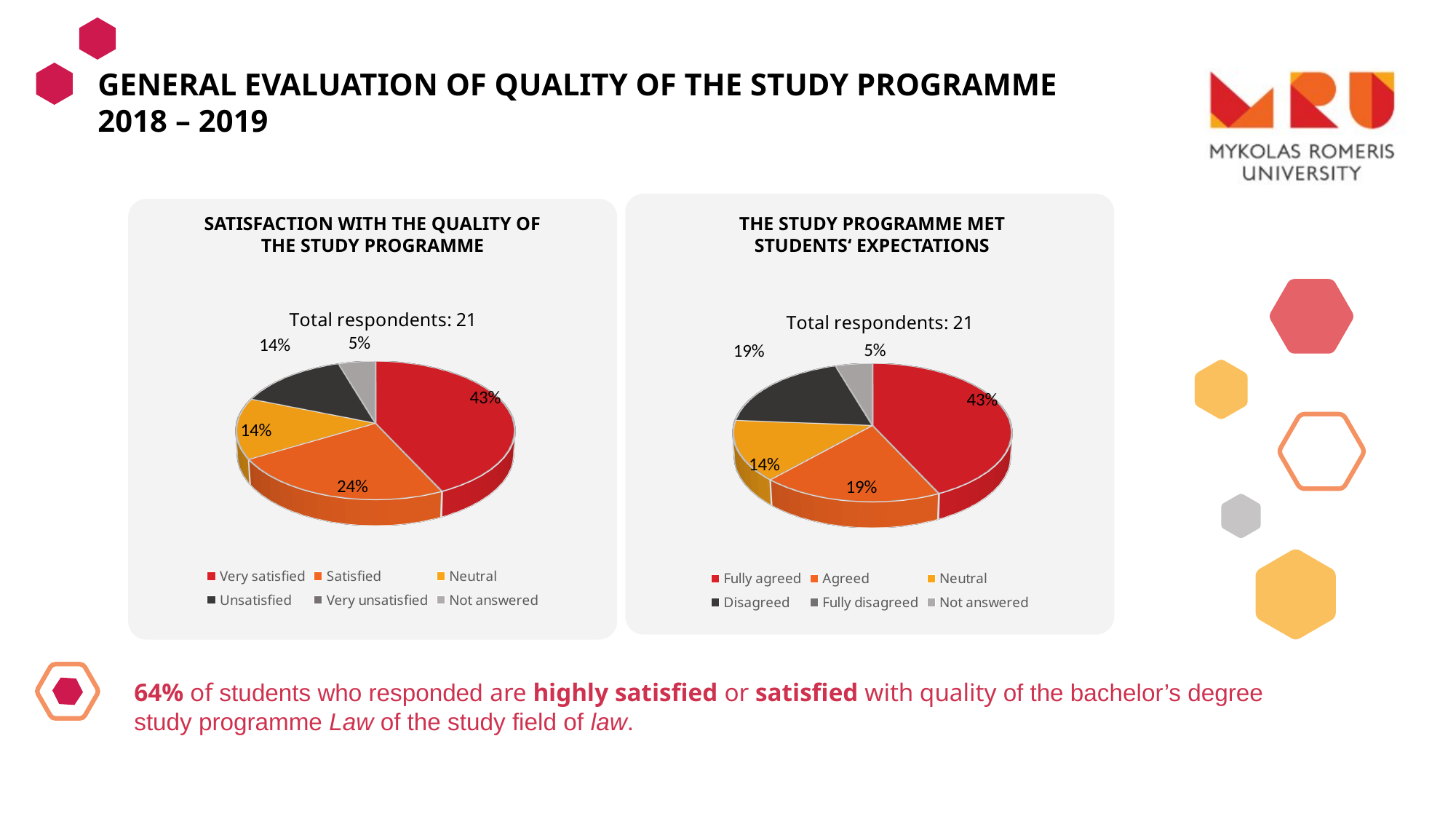
In the 'Satisfaction with the quality of the study programme' chart, what percentage of respondents were very satisfied? 43% In the 'Satisfaction with the quality of the study programme' chart, which category has the largest slice? Very satisfied In 'The study programme met students' expectations' chart, what is the difference between the 'Fully agreed' and 'Agreed' percentages? 24% How many total respondents are reported for the 'Satisfaction with the quality of the study programme' chart? 21 In 'The study programme met students' expectations' chart, what percentage of respondents disagreed? 19% In 'The study programme met students' expectations' chart, which is larger: the 'Agreed' slice or the 'Neutral' slice? Agreed What type of chart is used in the 'Satisfaction with the quality of the study programme' panel? Pie chart In 'The study programme met students' expectations' chart, what percentage of respondents fully agreed? 43% In the 'Satisfaction with the quality of the study programme' chart, what percentage of respondents did not answer? 5% How many entries does the legend of 'The study programme met students' expectations' chart list? 6 In the 'Satisfaction with the quality of the study programme' chart, what is the difference between the 'Very satisfied' and 'Satisfied' percentages? 19% In the 'Satisfaction with the quality of the study programme' chart, what share of the pie is the 'Satisfied' slice? 24%